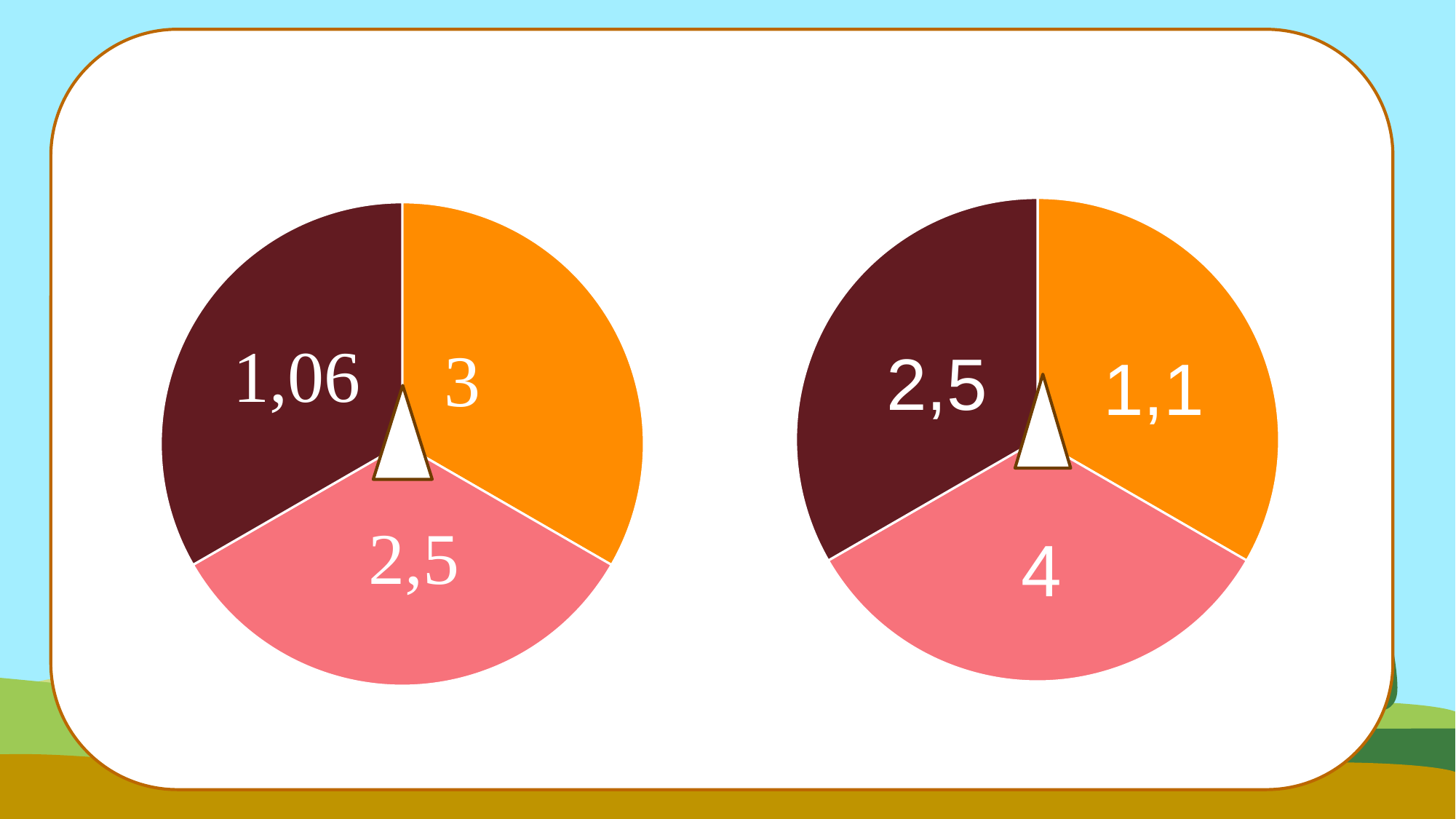
In the right pie chart, what is the difference between the values printed on the pink slice and the orange slice? 2,9 In the right pie chart, which colour slice carries the largest printed value? pink In the right pie chart, what value is printed on the pink slice? 4 In the left pie chart, what value is printed on the dark red slice? 1,06 What kind of chart is shown on the left of the slide? pie chart In the left pie chart, which is larger: the value on the orange slice or the value on the pink slice? orange slice In the left pie chart, what value is printed on the pink slice? 2,5 How many slices does the right pie chart have? 3 In the left pie chart, what value is printed on the orange slice? 3 In the left pie chart, which colour slice carries the smallest printed value? dark red In the right pie chart, what value is printed on the orange slice? 1,1 How many slices does the left pie chart have? 3